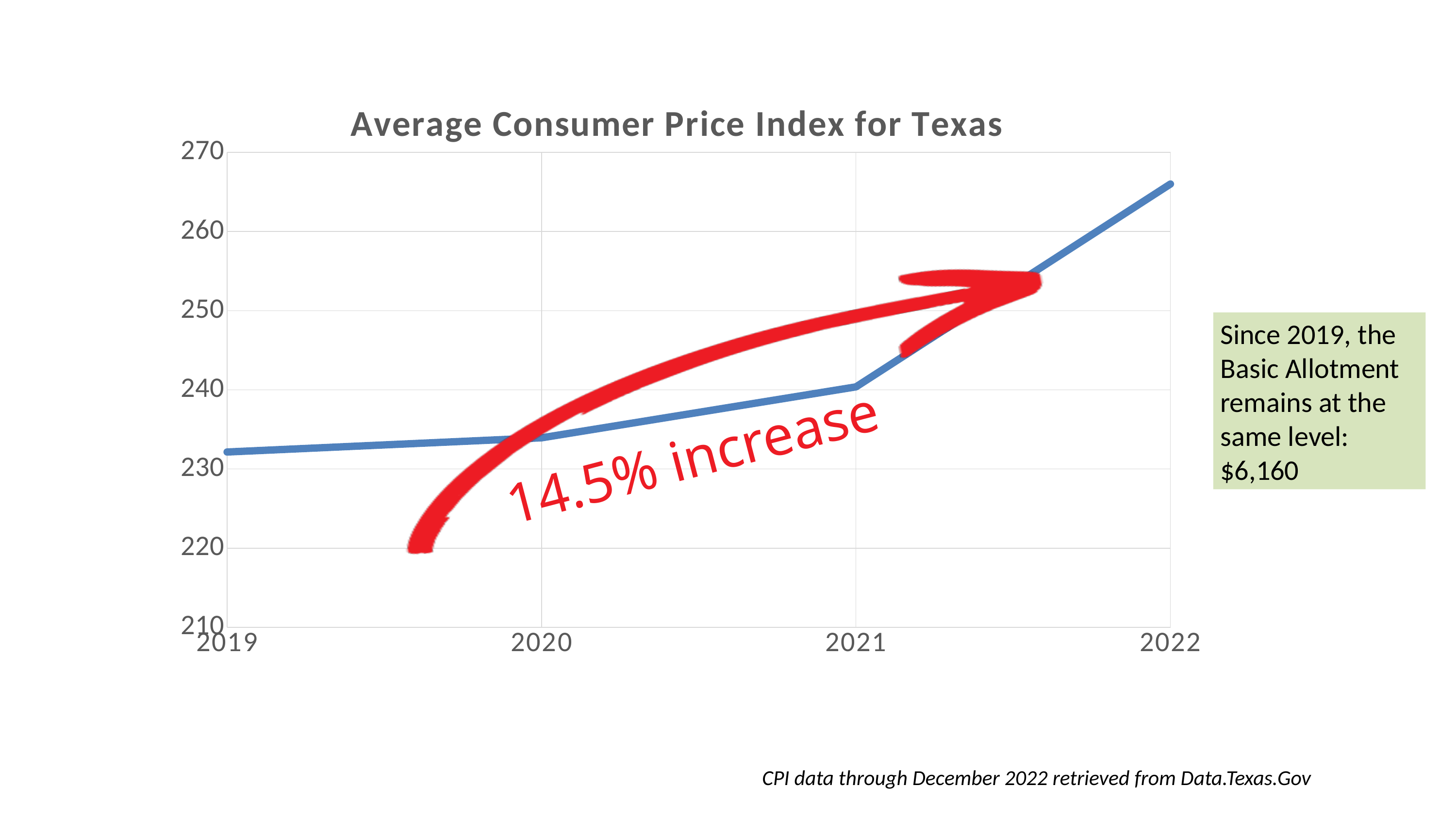
Is the value for 2022 greater or less than 260? greater Which year has the larger value, 2020 or 2021? 2021 Which year has the highest Average Consumer Price Index for Texas? 2022 How many years are plotted on the x axis of the chart? 4 Is the value for 2021 greater or less than 250? less What kind of chart is shown on the slide? line chart Is the value for 2019 greater or less than 240? less What is the title of the chart? Average Consumer Price Index for Texas What percentage increase does the red annotation on the chart state? 14.5% increase Do the values rise or fall from 2019 to 2022? rise Which year has the lowest Average Consumer Price Index for Texas? 2019